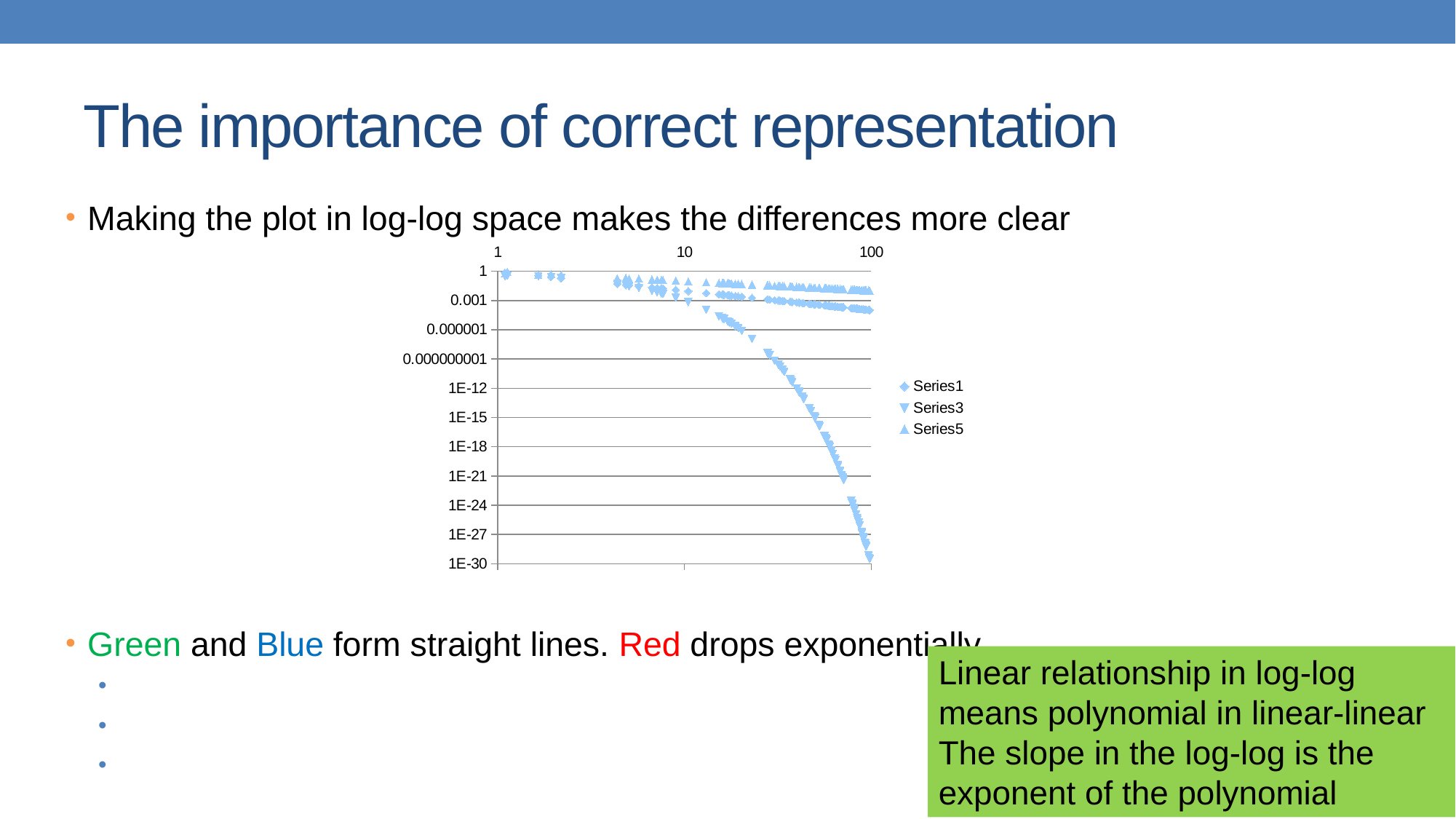
At x = 100, is the value for Series5 greater or less than 0.001? greater What kind of chart is shown on the slide? Scatter chart Which series in the chart drops most steeply as x increases? Series3 At x = 100, which series has larger values, Series1 or Series3? Series1 Which series has the highest values at x = 100? Series5 Do the values of Series3 rise or fall as x increases along the x axis? Fall How many series does the chart's legend list? 3 What are the names of the series listed in the chart's legend? Series1, Series3, Series5 At x = 100, is the value for Series1 greater or less than 0.000001? greater Which series has the lowest values at x = 100? Series3 At x = 100, is the value for Series3 greater or less than 1E-24? less What is the lowest tick label shown on the chart's y axis? 1E-30